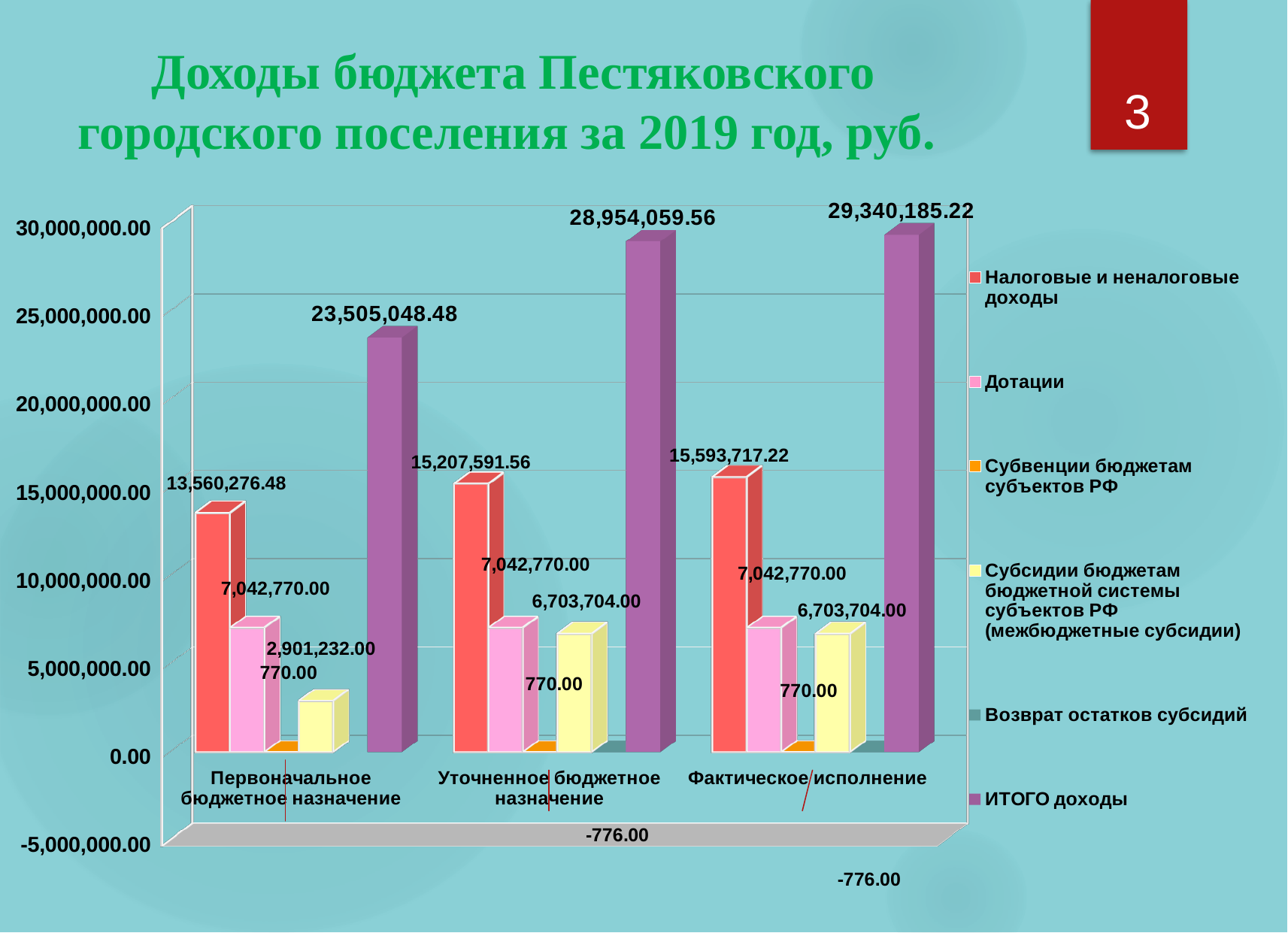
How many categories are shown on the x axis? 3 What is the value of Субсидии бюджетам бюджетной системы субъектов РФ for Уточненное бюджетное назначение? 6,703,704.00 Which category has the highest value of ИТОГО доходы? Фактическое исполнение How many series does the legend list? 6 What is the value of ИТОГО доходы for Фактическое исполнение? 29,340,185.22 Do the values of ИТОГО доходы rise or fall from Первоначальное бюджетное назначение to Фактическое исполнение? Rise What is the value of Дотации for Фактическое исполнение? 7,042,770.00 What is the value of Налоговые и неналоговые доходы for Первоначальное бюджетное назначение? 13,560,276.48 What is the difference between ИТОГО доходы for Фактическое исполнение and for Уточненное бюджетное назначение? 386,125.66 Which category has the lowest value of Налоговые и неналоговые доходы? Первоначальное бюджетное назначение What kind of chart is shown on the slide? Bar chart Which is larger: Налоговые и неналоговые доходы for Уточненное бюджетное назначение or for Фактическое исполнение? Фактическое исполнение